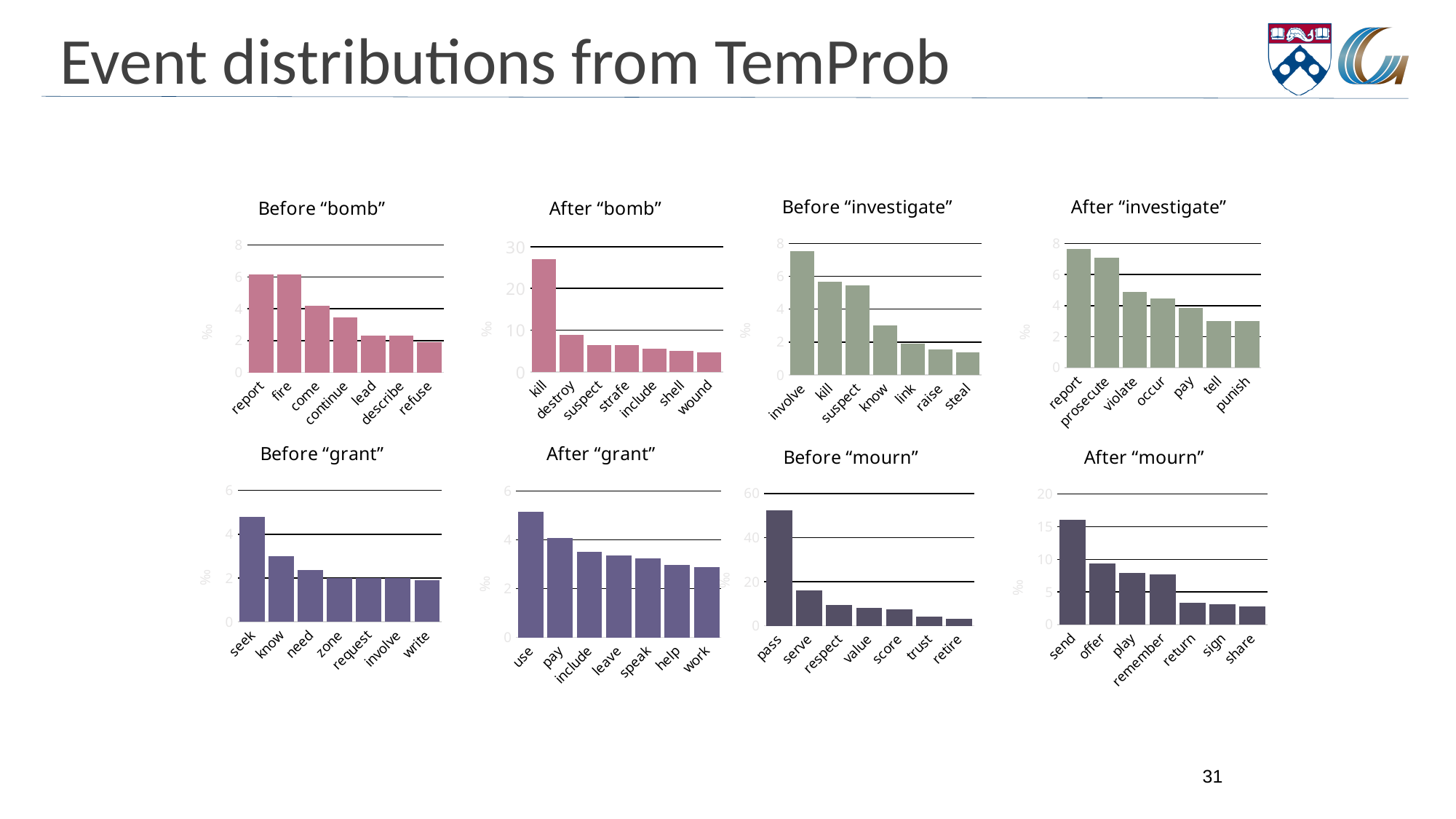
In the After "investigate" chart, which is larger, the value for violate or the value for pay? violate In the Before "mourn" chart, is the value for serve greater or less than 20? less In the After "bomb" chart, which category has the highest value? kill In the Before "investigate" chart, which category has the highest value? involve In the After "bomb" chart, is the value for kill greater or less than 20? greater How many categories are plotted in the After "mourn" chart? 7 In the After "grant" chart, is the value for use greater or less than 4? greater How many bar charts are shown on the slide? 8 In the Before "grant" chart, which category has the highest value? seek